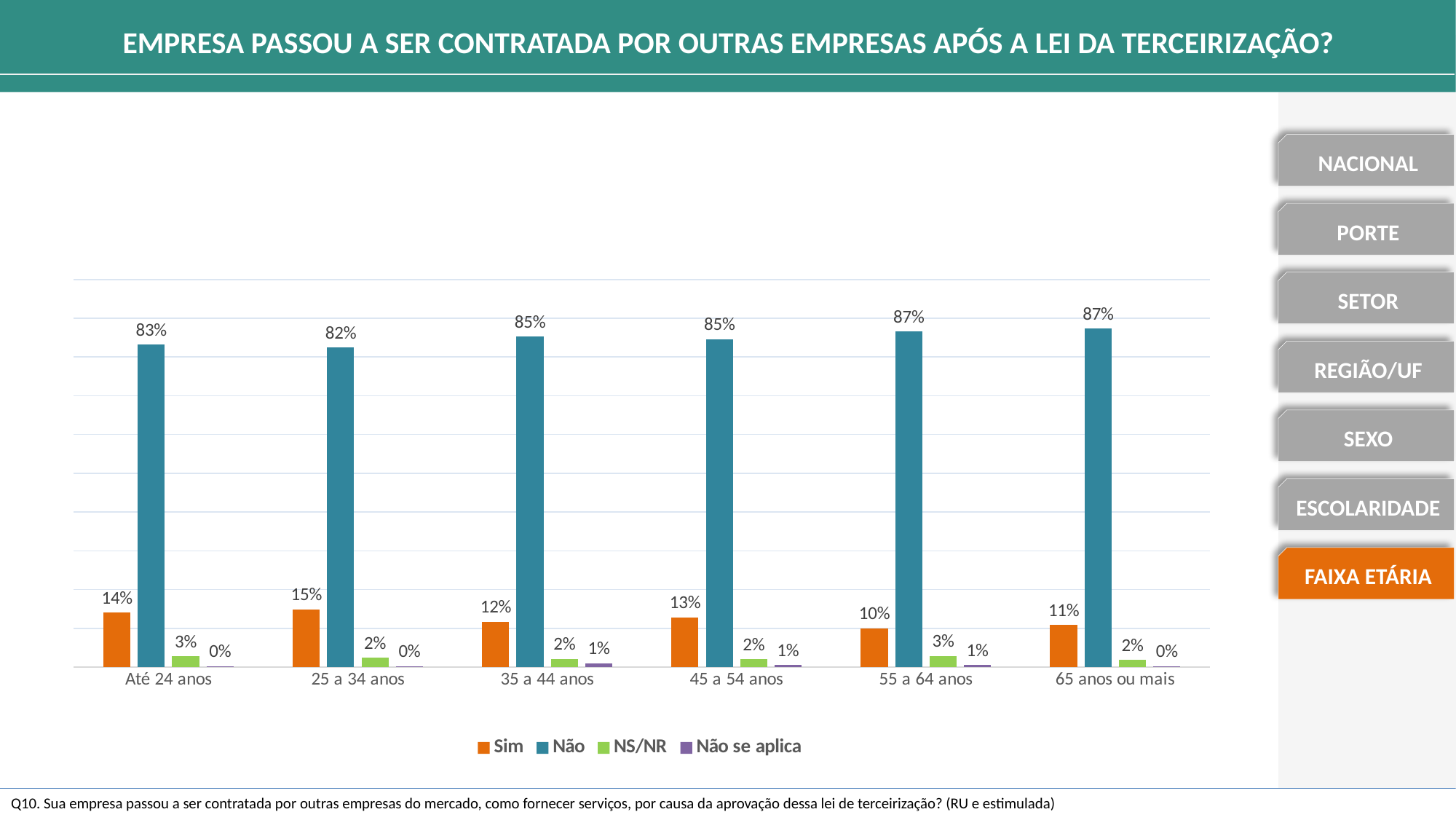
What is the value for "Não se aplica" in the "35 a 44 anos" category? 1% What is the difference between the "Não" values for "65 anos ou mais" and "25 a 34 anos"? 5% What kind of chart is shown on the slide? Bar chart Which age category has the highest value for "Sim"? 25 a 34 anos Which age category has the lowest value for "Sim"? 55 a 64 anos Which is larger: the "Sim" value for "Até 24 anos" or for "45 a 54 anos"? Até 24 anos Which series is shown in orange in the legend? Sim How many series does the legend list? 4 What is the value for "Não" in the "Até 24 anos" category? 83% What is the value for "NS/NR" in the "55 a 64 anos" category? 3% What is the value for "Sim" in the "25 a 34 anos" category? 15% How many age categories are shown on the x axis? 6